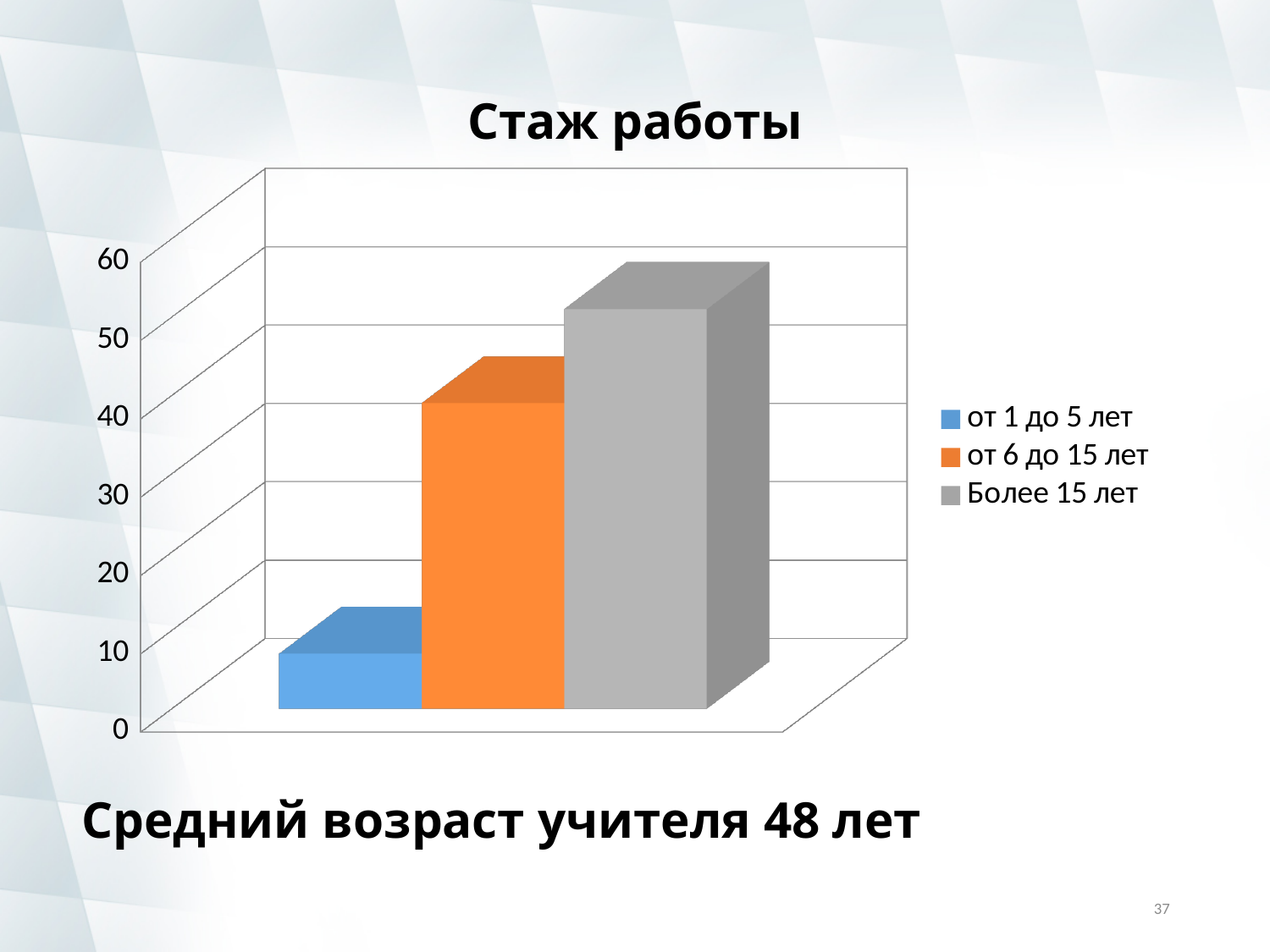
Which is larger, the value for "от 6 до 15 лет" or the value for "от 1 до 5 лет"? от 6 до 15 лет Is the value for "от 1 до 5 лет" greater or less than 20? less How many series does the legend list? 3 Is the value for "от 6 до 15 лет" greater or less than 30? greater What is the title of the chart? Стаж работы Which series has the highest value? Более 15 лет How many bars are plotted in the chart? 3 Is the value for "Более 15 лет" greater or less than 40? greater Which series has the lowest value? от 1 до 5 лет Which is larger, the value for "Более 15 лет" or the value for "от 6 до 15 лет"? Более 15 лет What kind of chart is shown on the slide? bar chart What colour is the bar for "от 6 до 15 лет"? orange